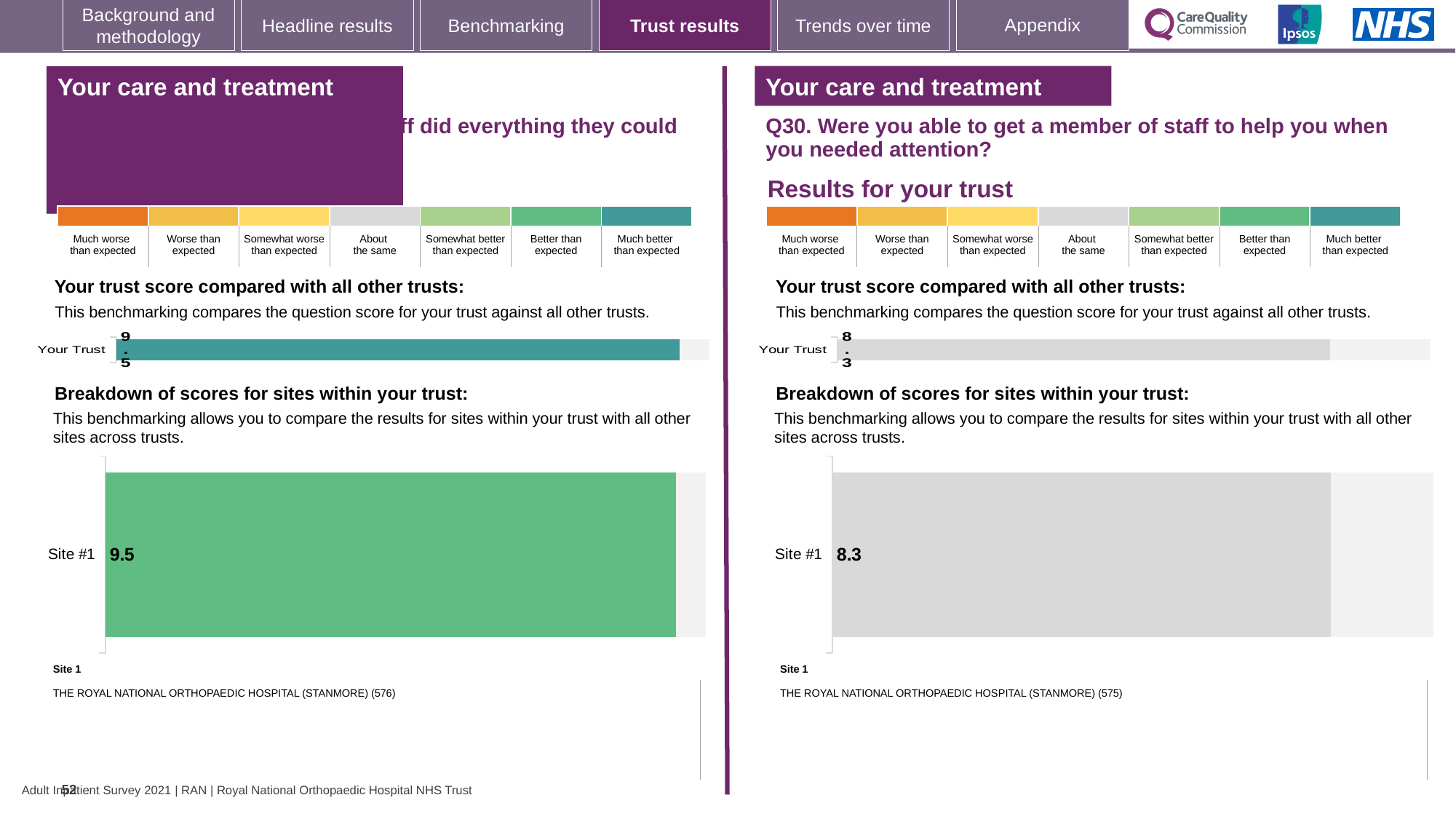
In the right-hand Q30 'Breakdown of scores for sites within your trust' chart, what is the score for Site #1? 8.3 How many sites are plotted in the left-hand 'Breakdown of scores for sites within your trust' chart? 1 In the left-hand 'Breakdown of scores for sites within your trust' chart, what is the score for Site #1? 9.5 What is the difference between the Site #1 score on the left-hand chart (9.5) and the Site #1 score on the right-hand Q30 chart (8.3)? 1.2 On the right-hand Q30 chart, what is the trust score shown for 'Your Trust'? 8.3 What kind of chart is used for the 'Breakdown of scores for sites within your trust' on the right-hand side? bar chart What colour is the Site #1 bar in the left-hand site breakdown chart? green Which is higher: the 'Your Trust' score on the left-hand chart or the 'Your Trust' score on the right-hand Q30 chart? the left-hand chart On the left-hand chart, what is the trust score shown for 'Your Trust'? 9.5 How many benchmark categories are shown in the colour scale above the right-hand Q30 chart, from 'Much worse than expected' to 'Much better than expected'? 7 How many sites are plotted in the right-hand Q30 'Breakdown of scores for sites within your trust' chart? 1